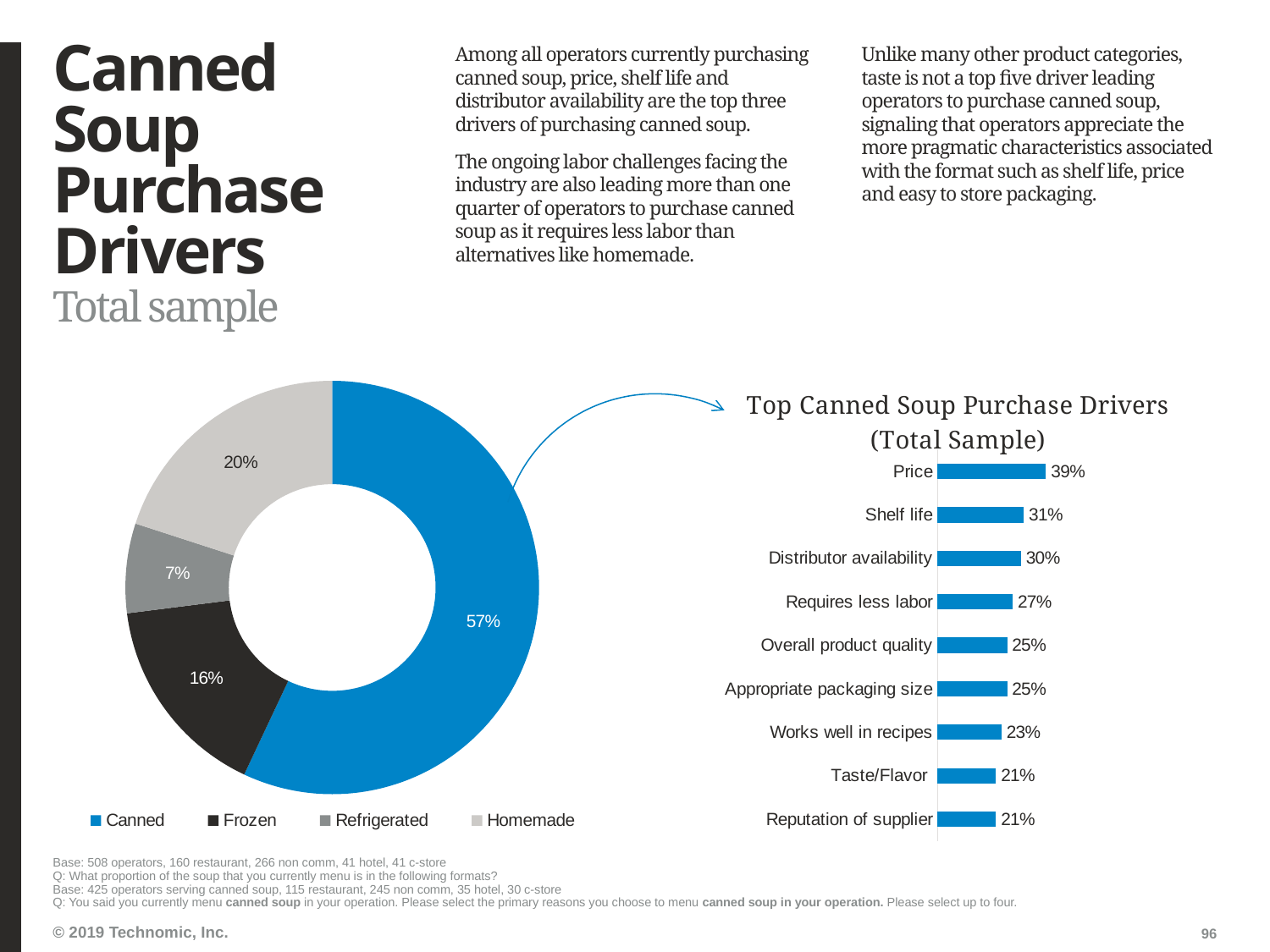
In the doughnut chart on the left, what share of soup menued is Canned? 57% In the doughnut chart on the left, which format has the smallest share? Refrigerated In the 'Top Canned Soup Purchase Drivers (Total Sample)' chart, which driver has the highest value? Price In the 'Top Canned Soup Purchase Drivers (Total Sample)' chart, how many drivers are shown? 9 In the 'Top Canned Soup Purchase Drivers (Total Sample)' chart, which is larger, Works well in recipes or Taste/Flavor? Works well in recipes In the 'Top Canned Soup Purchase Drivers (Total Sample)' chart, what is the difference between Price and Shelf life? 8% In the doughnut chart on the left, what share is Homemade? 20% What kind of chart is the 'Top Canned Soup Purchase Drivers (Total Sample)' chart? Bar chart In the doughnut chart on the left, how many formats does the legend list? 4 In the doughnut chart on the left, what is the difference between the Frozen and Refrigerated shares? 9% In the 'Top Canned Soup Purchase Drivers (Total Sample)' chart, what is the value for Price? 39% In the 'Top Canned Soup Purchase Drivers (Total Sample)' chart, what is the value for Requires less labor? 27%